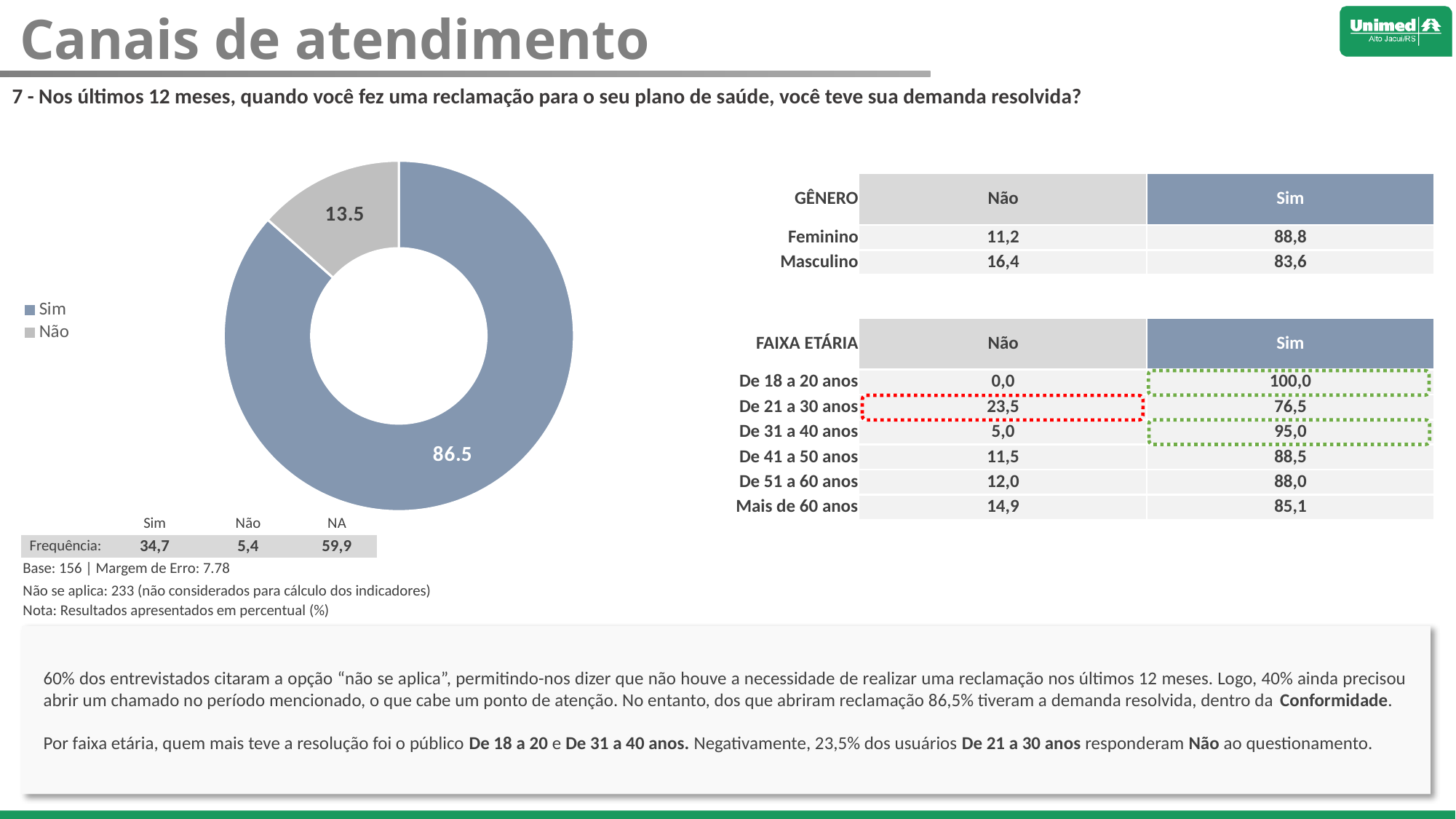
How many slices does the donut chart have? 2 In the donut chart, which is larger, Sim or Não? Sim Which slice of the donut chart is the largest? Sim What are the two legend entries of the donut chart? Sim and Não What colour is the Sim slice in the donut chart? Blue-grey What value is shown for the Não slice of the donut chart? 13.5 How many entries does the legend of the donut chart list? 2 What is the difference between the Sim and Não values in the donut chart? 73 What kind of chart is shown on the slide? Pie (donut) chart Which slice of the donut chart is the smallest? Não What value is shown for the Sim slice of the donut chart? 86.5 What share of the donut chart does the Sim slice represent? 86.5%